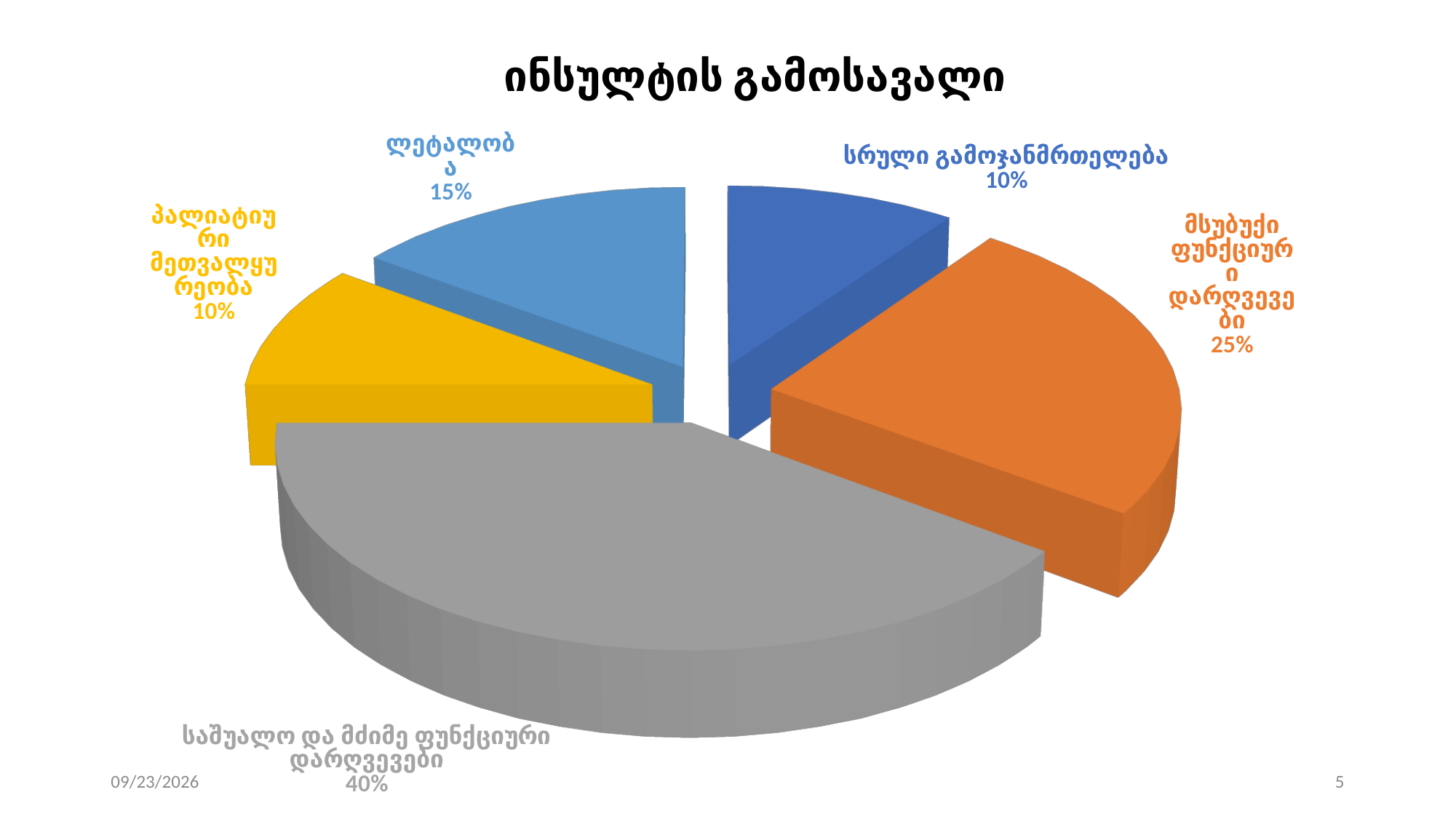
Which is larger, the ლეტალობა slice or the სრული გამოჯანმრთელება slice? ლეტალობა What share of the pie is labelled მსუბუქი ფუნქციური დარღვევები? 25% How many slices does the pie chart have? 5 Which slice of the pie is the largest? საშუალო და მძიმე ფუნქციური დარღვევები What share of the pie is labelled სრული გამოჯანმრთელება? 10% What share of the pie is labelled ლეტალობა? 15% What kind of chart is shown on the slide? pie chart What is the title of the chart? ინსულტის გამოსავალი What is the difference in percentage points between the საშუალო და მძიმე ფუნქციური დარღვევები slice and the მსუბუქი ფუნქციური დარღვევები slice? 15 What colour is the slice labelled მსუბუქი ფუნქციური დარღვევები? orange